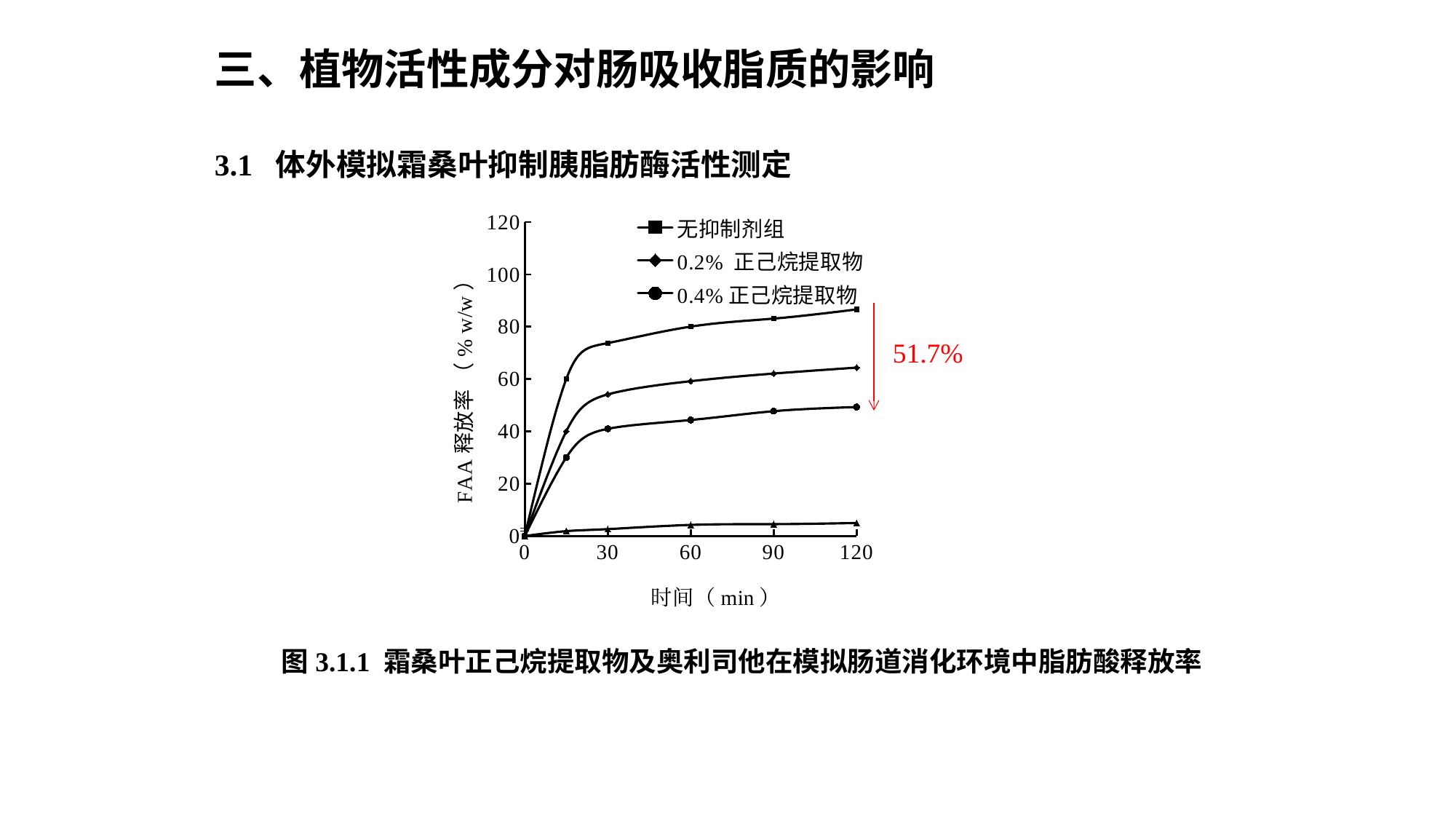
Which series has the highest FAA 释放率 at 120 min? 无抑制剂组 Does the FAA 释放率 for 无抑制剂组 rise or fall as time increases from 0 to 120 min? rise What percentage is written in red next to the arrow on the right of the chart? 51.7% What is the label of the x axis? 时间（min） How many series does the legend list? 3 Among the three legend series, which has the lowest FAA 释放率 at 120 min? 0.4% 正己烷提取物 Is the value for 0.4% 正己烷提取物 at 120 min greater or less than 60? less What kind of chart is shown on the slide? line chart Is the value for 无抑制剂组 at 30 min greater or less than 60? greater Is the value for 无抑制剂组 at 120 min greater or less than 80? greater Which is larger at 60 min: the value for 0.2% 正己烷提取物 or the value for 0.4% 正己烷提取物? 0.2% 正己烷提取物